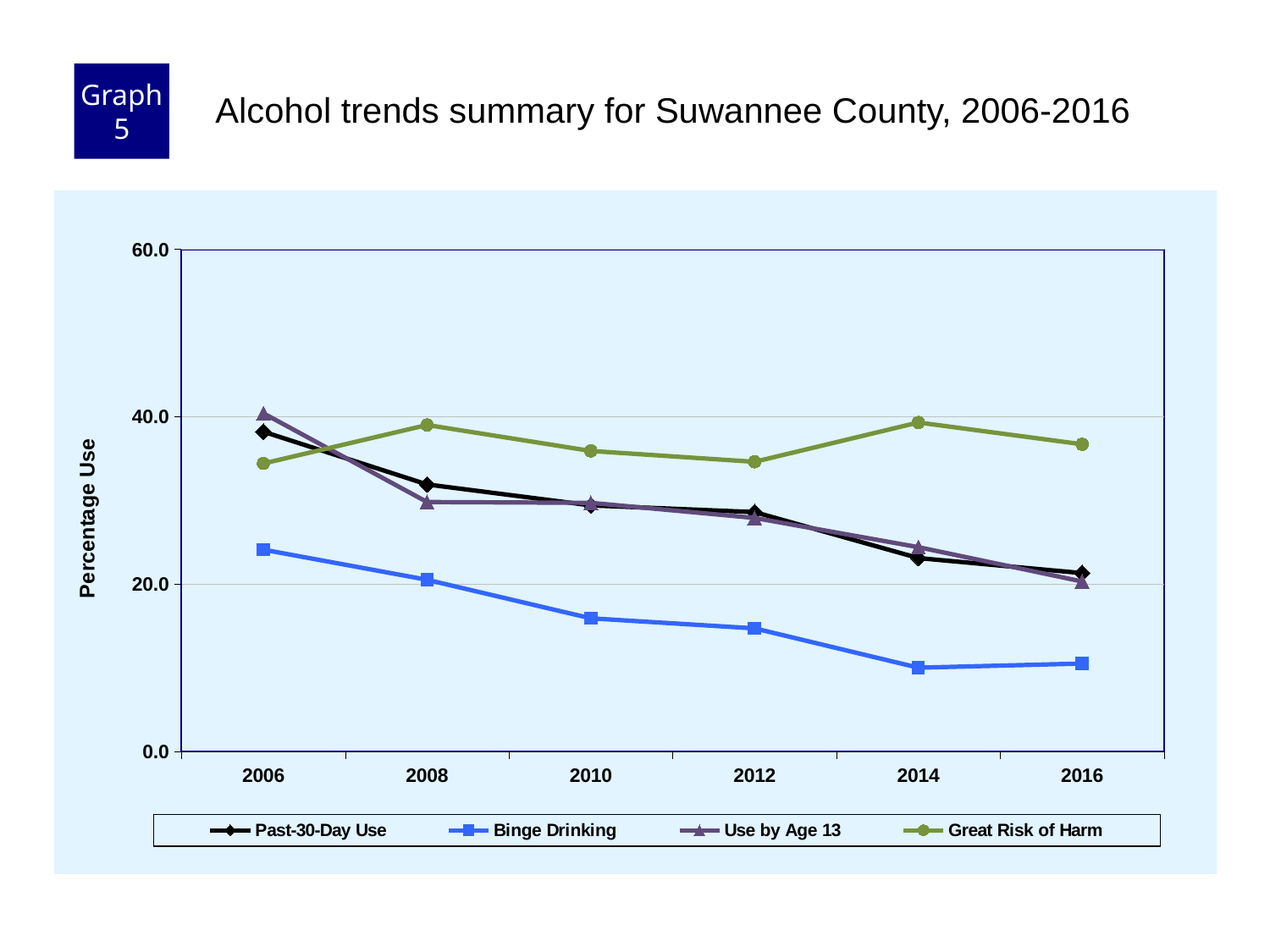
In which year is Binge Drinking at its highest? 2006 What is the label on the y axis? Percentage Use Which series has the lowest value in 2016? Binge Drinking Does the Binge Drinking line generally rise or fall from 2006 to 2016? fall Which is larger for Past-30-Day Use: the value in 2006 or the value in 2016? 2006 Is the value for Past-30-Day Use in 2006 greater or less than 40.0? less How many series does the legend list? 4 Is the value for Binge Drinking in 2006 greater or less than 20.0? greater How many years are plotted along the x axis? 6 Which series has the highest value in 2016? Great Risk of Harm Is the value for Binge Drinking in 2014 greater or less than 20.0? less What kind of chart is shown on the slide? line chart